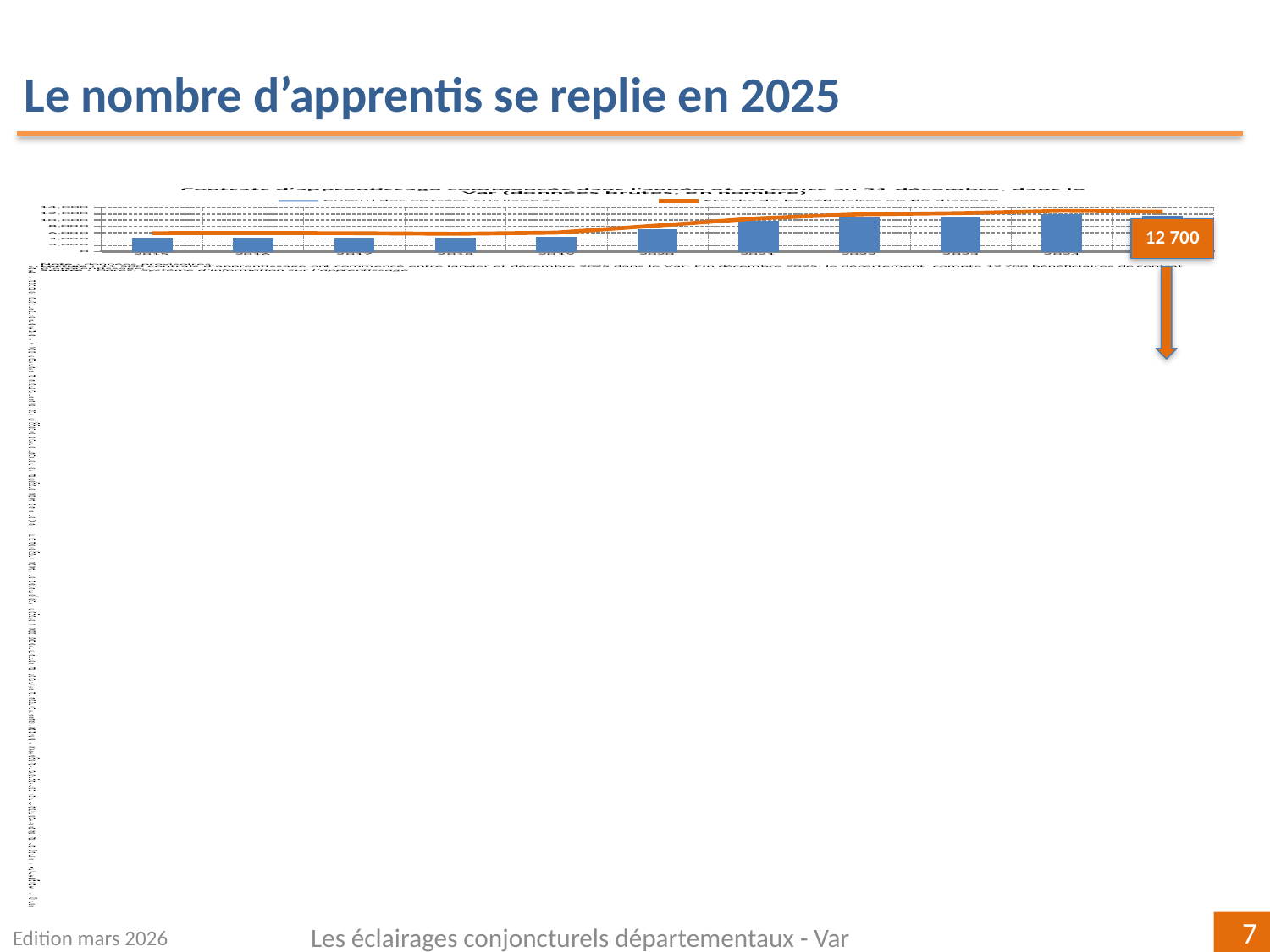
How many series does the chart's legend list? 2 Do the blue bars generally rise or fall from left to right along the x axis? Rise Does the orange line rise or fall from the left side of the chart to the middle? Rise What kind of chart is shown on the slide? A bar chart combined with a line What value is printed in the orange callout box at the right of the chart? 12 700 What are the two series named in the chart's legend? Cumul des entrées sur l'année; Stocks de bénéficiaires en fin d'année Which is taller, the leftmost blue bar or the rightmost blue bar? The rightmost bar How many blue bars are plotted in the chart? 11